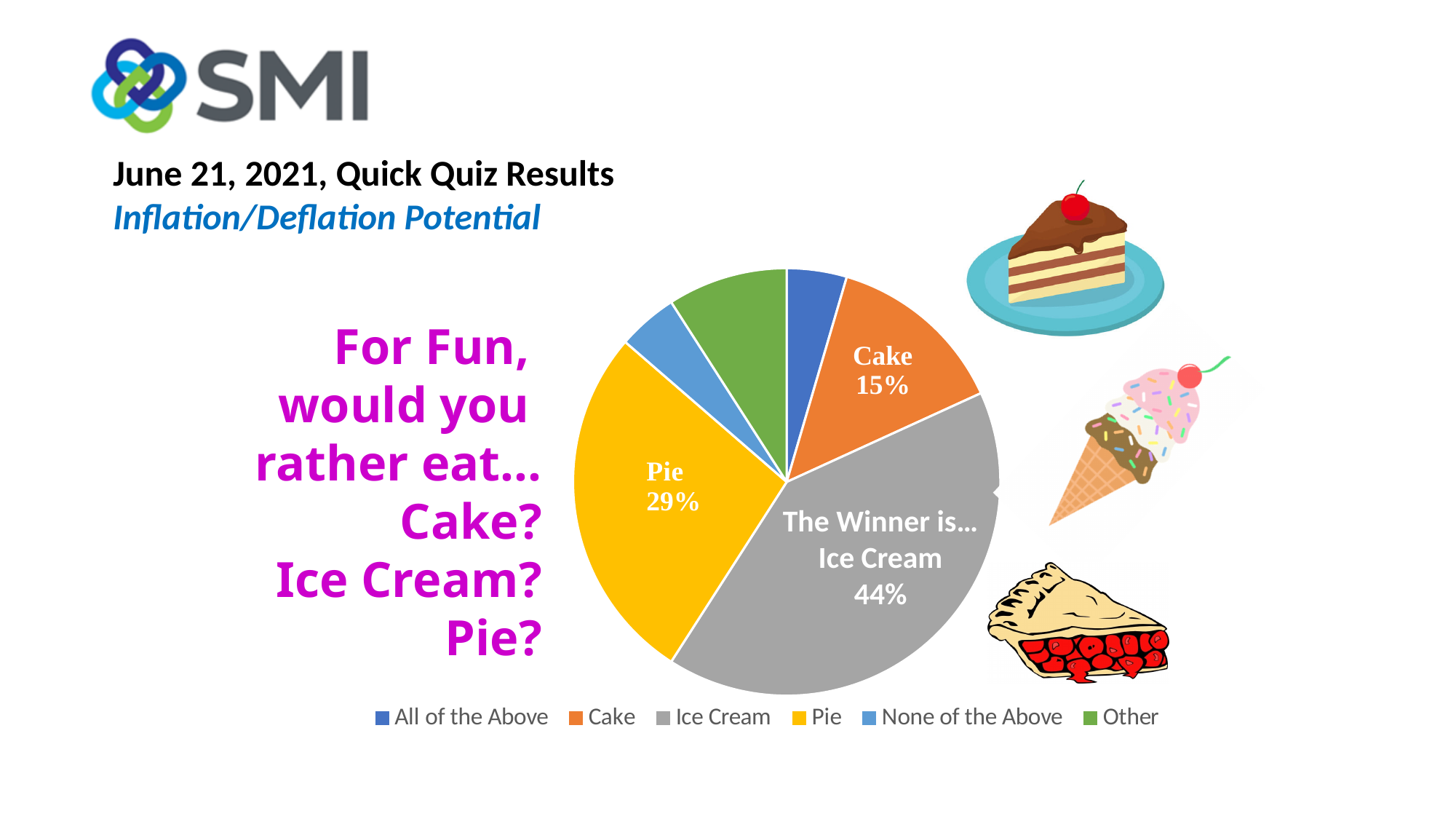
Which is larger, the share for Pie or the share for Cake? Pie What percentage of respondents chose Pie? 29% How many categories does the legend list? 6 What percentage of respondents chose Cake? 15% What percentage of respondents chose Ice Cream? 44% What is the difference in percentage points between Ice Cream and Pie? 15 Which is larger, the slice for Other or the slice for None of the Above? Other What colour is the Pie slice? yellow Which category has the largest slice of the pie? Ice Cream Which is larger, the slice for Cake or the slice for Other? Cake What kind of chart is shown on the slide? pie chart What is the difference in percentage points between Pie and Cake? 14